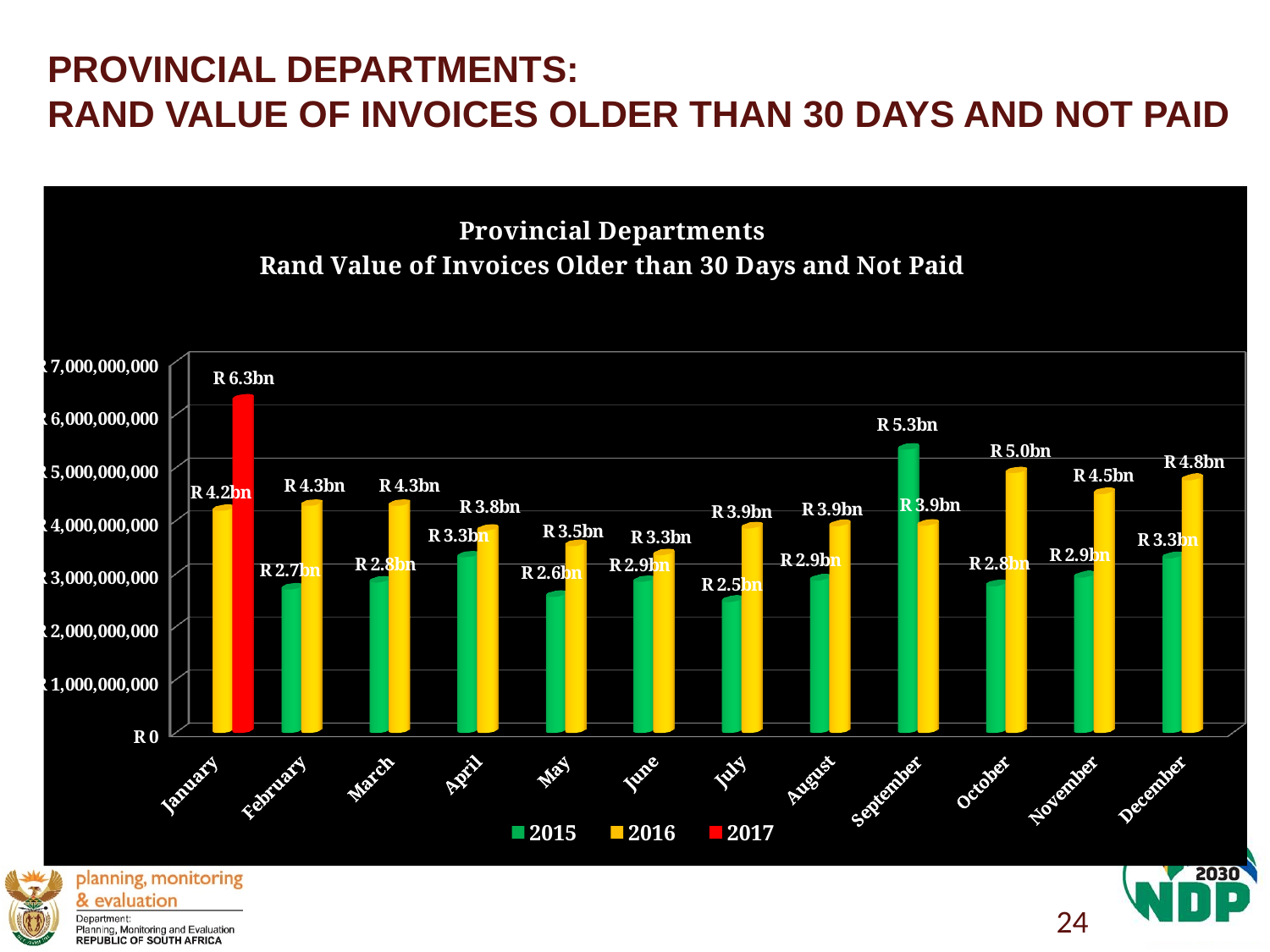
What is the value for 2016 in October? R 5.0bn Which month has the lowest value for the 2015 series? July How many months are shown on the x axis? 12 How many series does the legend list? 3 Which colour represents the 2017 series in the legend? Red Which month has the highest value for the 2016 series? October What kind of chart is shown on the slide? Bar chart What is the difference between the 2016 and 2015 values in October? R 2.1bn What is the value for 2017 in January? R 6.3bn What is the value for 2015 in September? R 5.3bn In September, which series has the larger value, 2015 or 2016? 2015 What is the value for 2015 in July? R 2.5bn